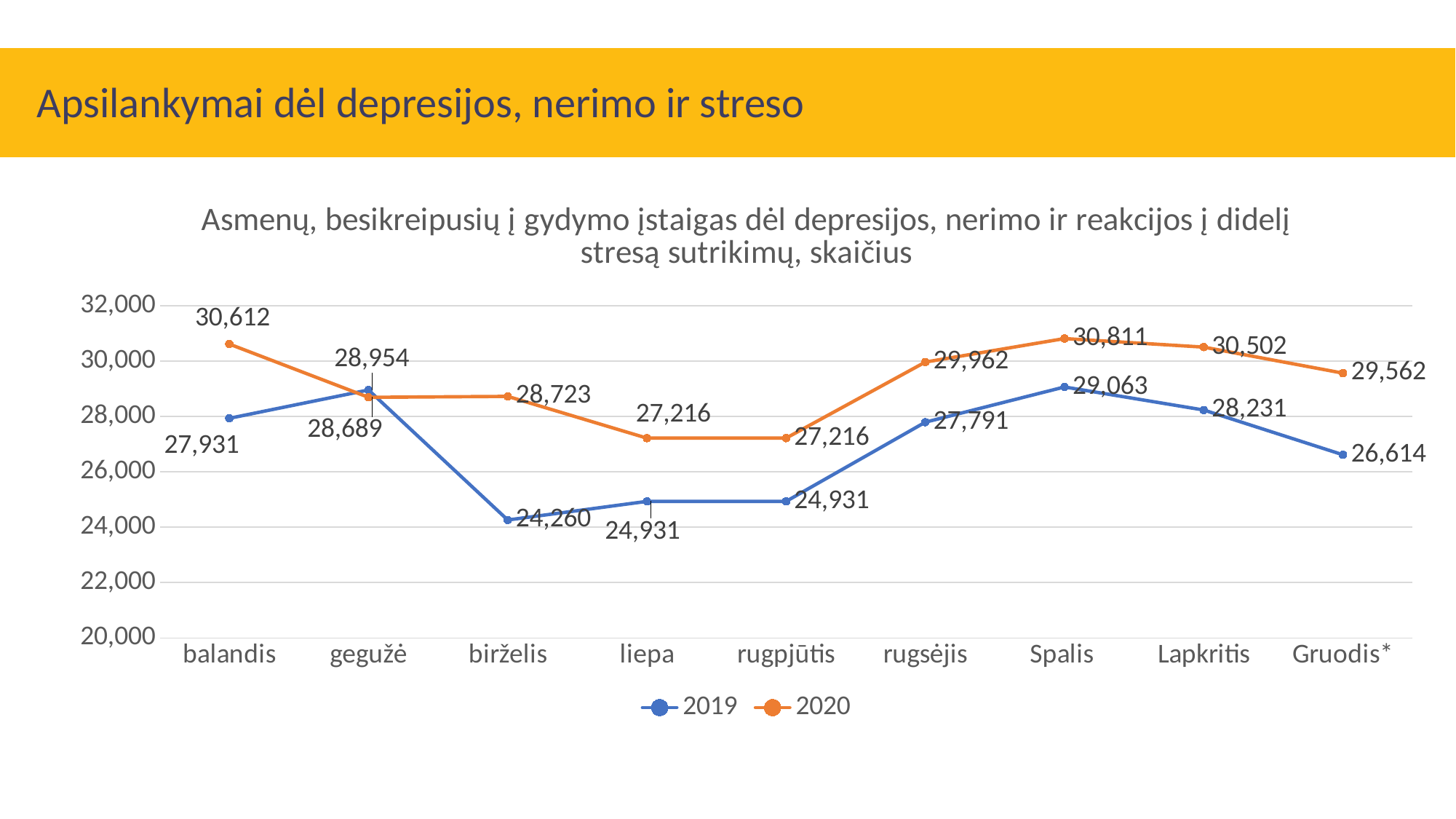
In which month does the 2019 series reach its lowest value? birželis How many months are shown on the x axis? 9 What is the difference between the 2020 and 2019 values in Spalis? 1,748 In which month does the 2020 series reach its highest value? Spalis What kind of chart is shown on the slide? line chart What is the value for 2020 in balandis? 30,612 How many series does the legend list? 2 What is the difference between the 2020 and 2019 values in balandis? 2,681 What is the value for 2019 in Gruodis*? 26,614 In gegužė, which series has the larger value, 2019 or 2020? 2019 Is the value for 2019 in liepa greater or less than 26,000? less What is the value for 2019 in birželis? 24,260